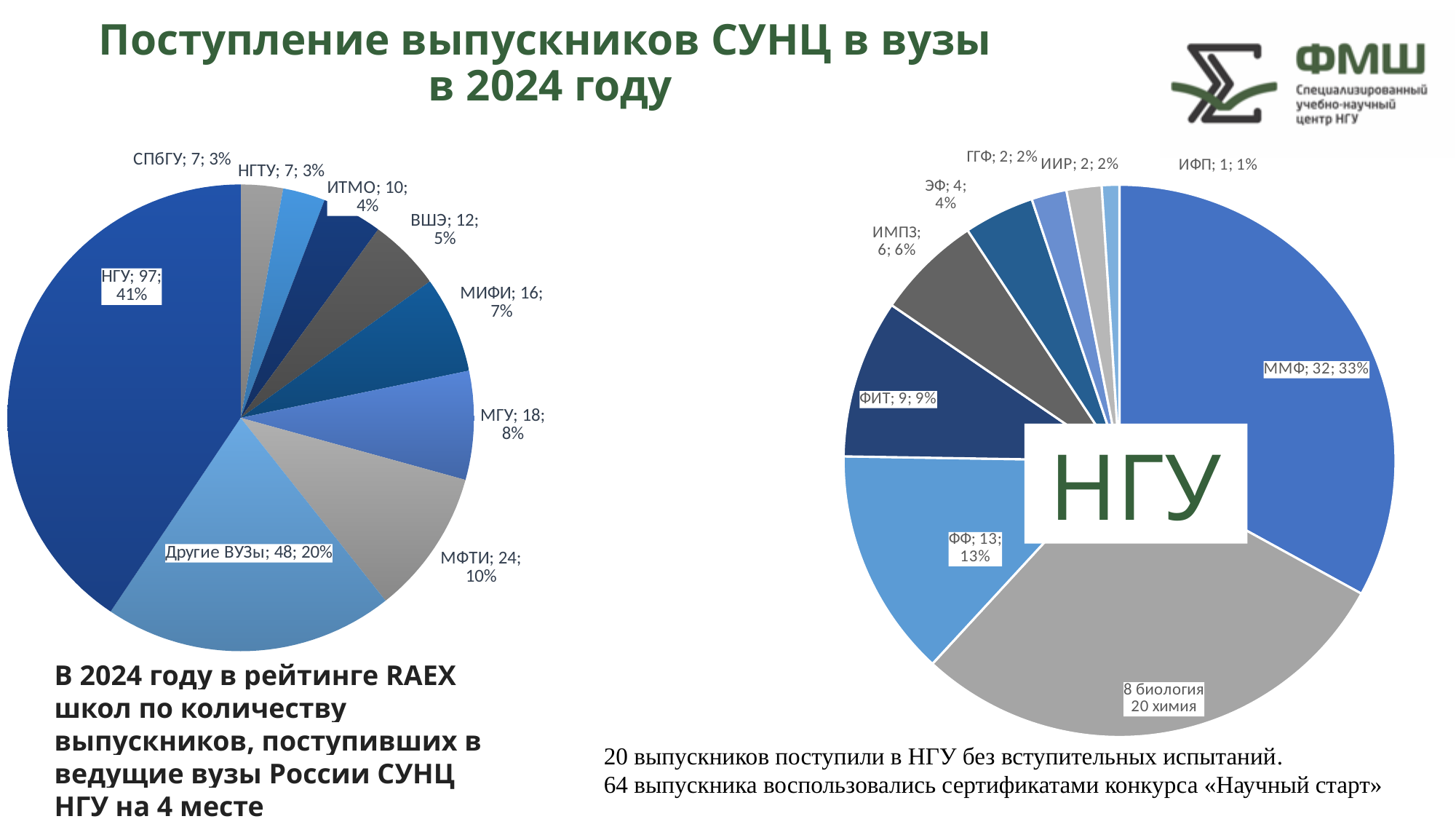
On the left pie chart, how many graduates entered НГУ? 97 On the left pie chart, what share of graduates went to МФТИ? 10% On the right pie chart, what share does ФФ have? 13% What type of chart is shown on the right side of the slide? Pie chart On the left pie chart, how many more graduates entered МГУ than МИФИ? 2 On the left pie chart, which is larger: the value for ВШЭ or the value for ИТМО? ВШЭ On the left pie chart, which university has the largest slice? НГУ On the right pie chart, which faculty has the smallest slice? ИФП On the right pie chart, how many graduates entered ММФ? 32 How many slices does the left pie chart have? 9 What is the title of the slide containing the two pie charts? Поступление выпускников СУНЦ в вузы в 2024 году On the right pie chart, what is the difference between the values for ФИТ and ИМПЗ? 3